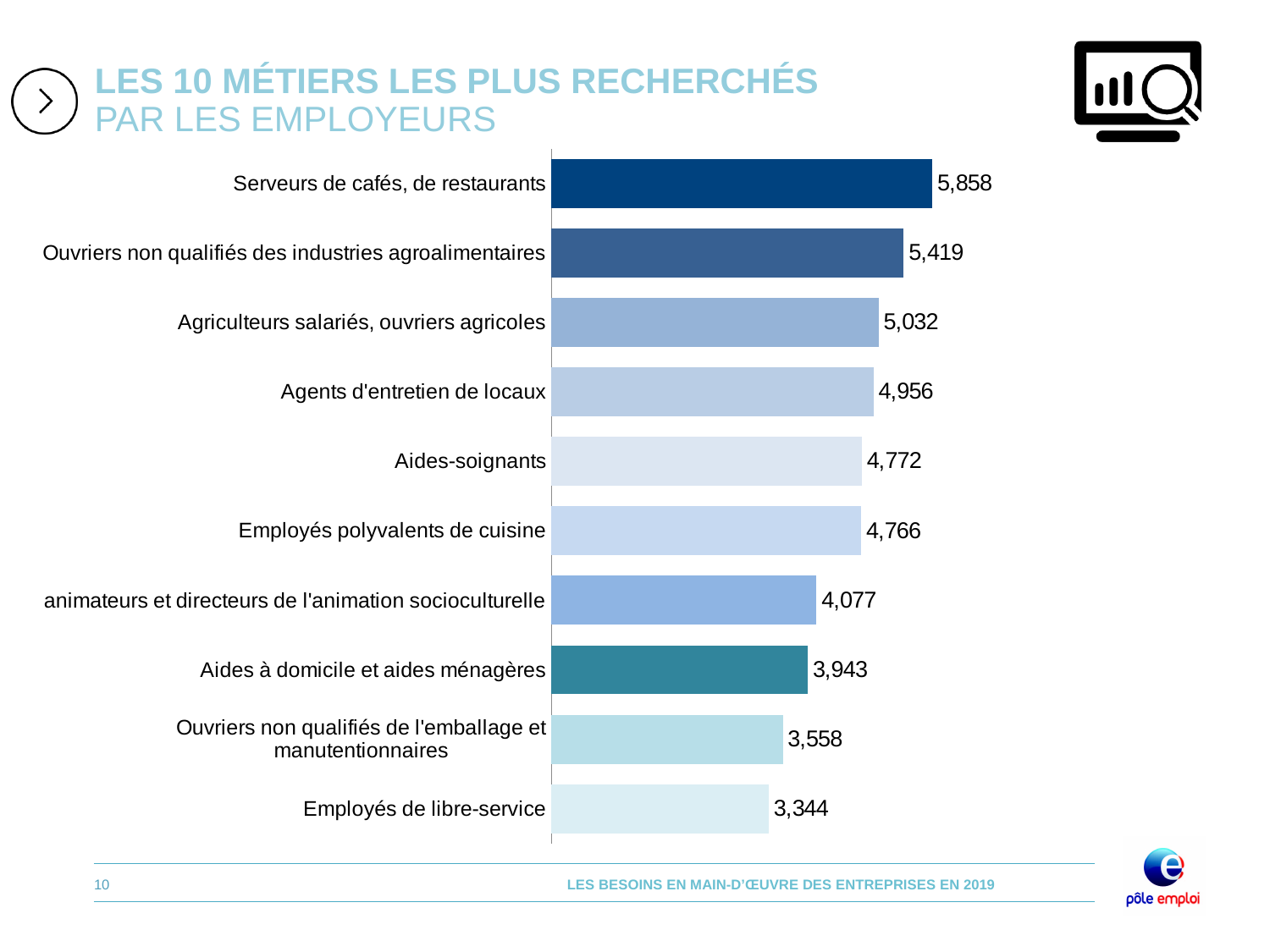
What kind of chart is shown on the slide? Bar chart Which category has the highest value? Serveurs de cafés, de restaurants Which is larger: the value for Agriculteurs salariés, ouvriers agricoles or the value for Agents d'entretien de locaux? Agriculteurs salariés, ouvriers agricoles Which category has the lowest value? Employés de libre-service What is the value for Aides-soignants? 4,772 How many categories are shown in the chart? 10 What is the value for Serveurs de cafés, de restaurants? 5,858 Which is larger: the value for animateurs et directeurs de l'animation socioculturelle or the value for Aides à domicile et aides ménagères? animateurs et directeurs de l'animation socioculturelle What is the difference between the values for Serveurs de cafés, de restaurants and Ouvriers non qualifiés des industries agroalimentaires? 439 What is the difference between the values for Aides à domicile et aides ménagères and Ouvriers non qualifiés de l'emballage et manutentionnaires? 385 What is the value for Employés de libre-service? 3,344 What is the title of the chart on the slide? LES 10 MÉTIERS LES PLUS RECHERCHÉS PAR LES EMPLOYEURS